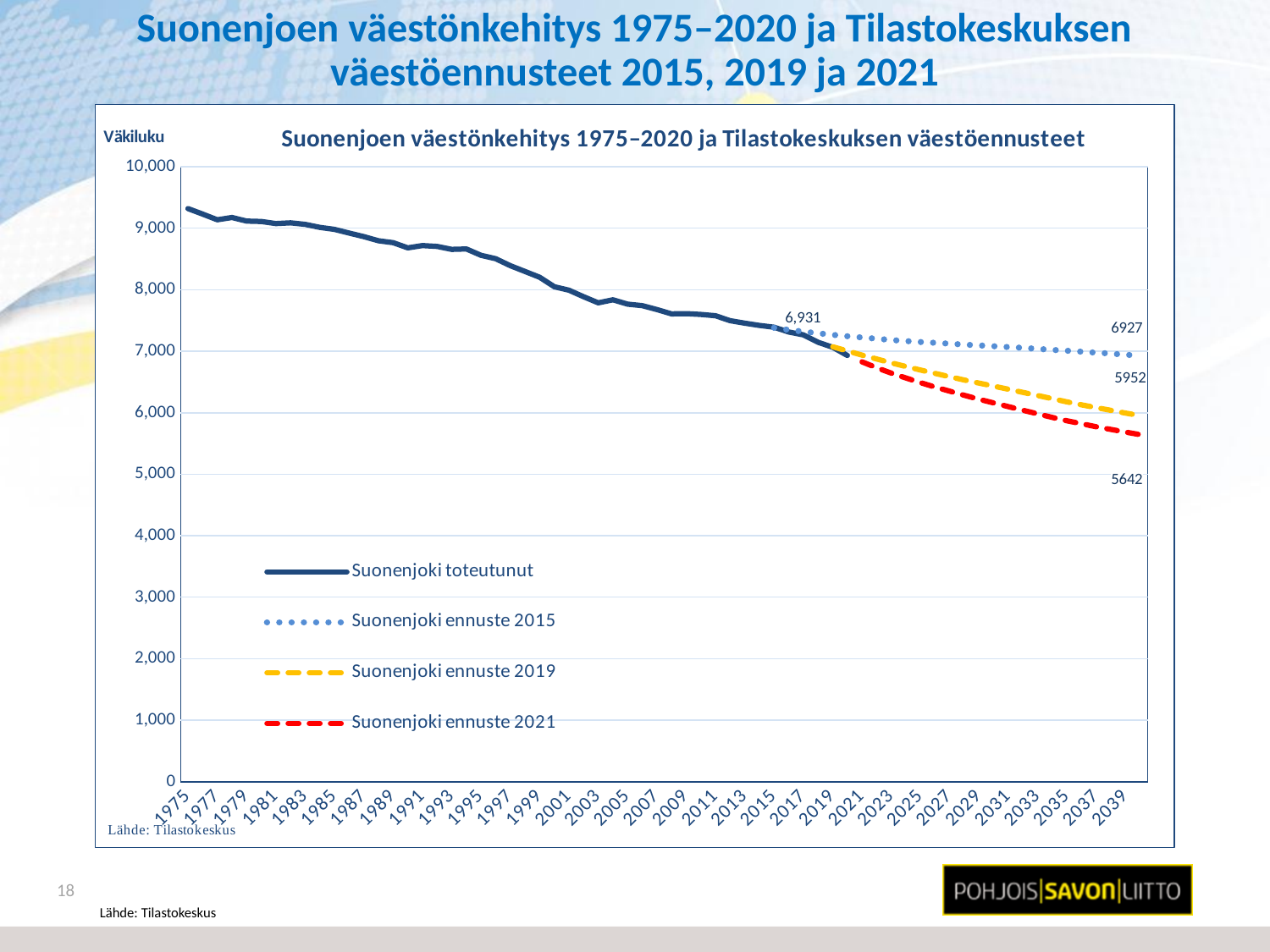
How many series does the legend list? 4 What is the difference between the final labelled values of the ennuste 2015 series (6927) and the ennuste 2021 series (5642)? 1285 Which forecast series ends at the lowest value? Suonenjoki ennuste 2021 Does the Suonenjoki toteutunut series rise or fall from 1975 to 2020? fall What label is shown on the vertical axis of the chart? Väkiluku Is the value of the Suonenjoki toteutunut series in 1975 greater or less than 9,000? greater What is the difference between the final labelled values of the ennuste 2019 series (5952) and the ennuste 2021 series (5642)? 310 What is the final labelled value of the Suonenjoki ennuste 2021 series? 5642 What is the final labelled value of the Suonenjoki ennuste 2019 series? 5952 What is the final labelled value of the Suonenjoki ennuste 2015 series? 6927 What kind of chart is shown on the slide? line chart Which forecast series ends at a higher value, Suonenjoki ennuste 2019 or Suonenjoki ennuste 2021? Suonenjoki ennuste 2019